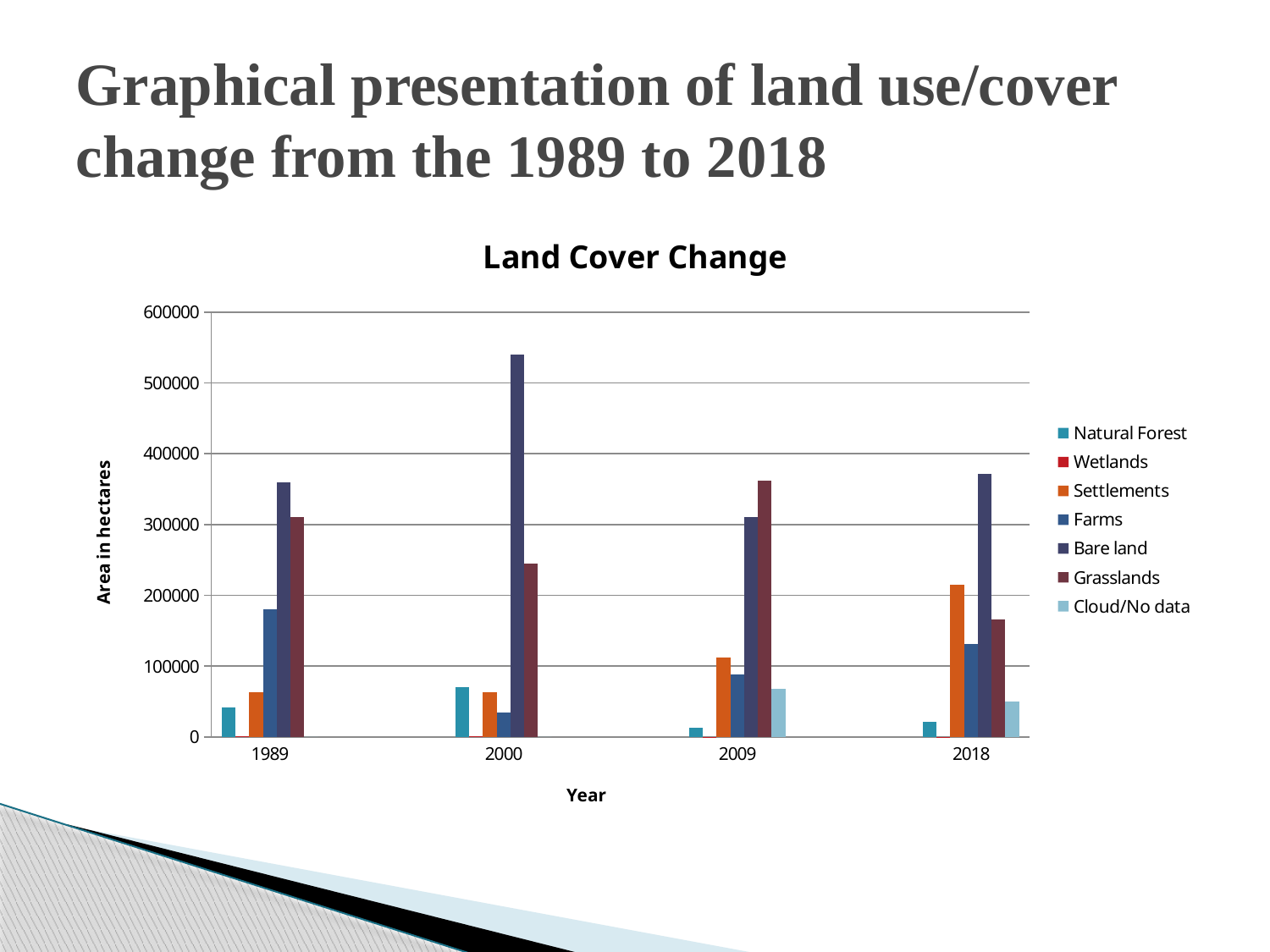
Which is larger, the Natural Forest value for 2000 or the Natural Forest value for 1989? 2000 Do the Settlements values generally rise or fall from 1989 to 2018? rise Is the Farms value for 1989 greater or less than 200000? less How many years are shown on the x axis of the Land Cover Change chart? 4 In which year is the Bare land value highest? 2000 Is the Bare land value for 2000 greater or less than 500000? greater Is the Grasslands value for 2018 greater or less than 200000? less Which is larger, the Settlements value for 2018 or the Settlements value for 1989? 2018 What kind of chart is shown on the slide? bar chart What is the title of the y axis of the chart? Area in hectares How many series does the legend of the Land Cover Change chart list? 7 In 2009, which land cover category has the largest area? Grasslands